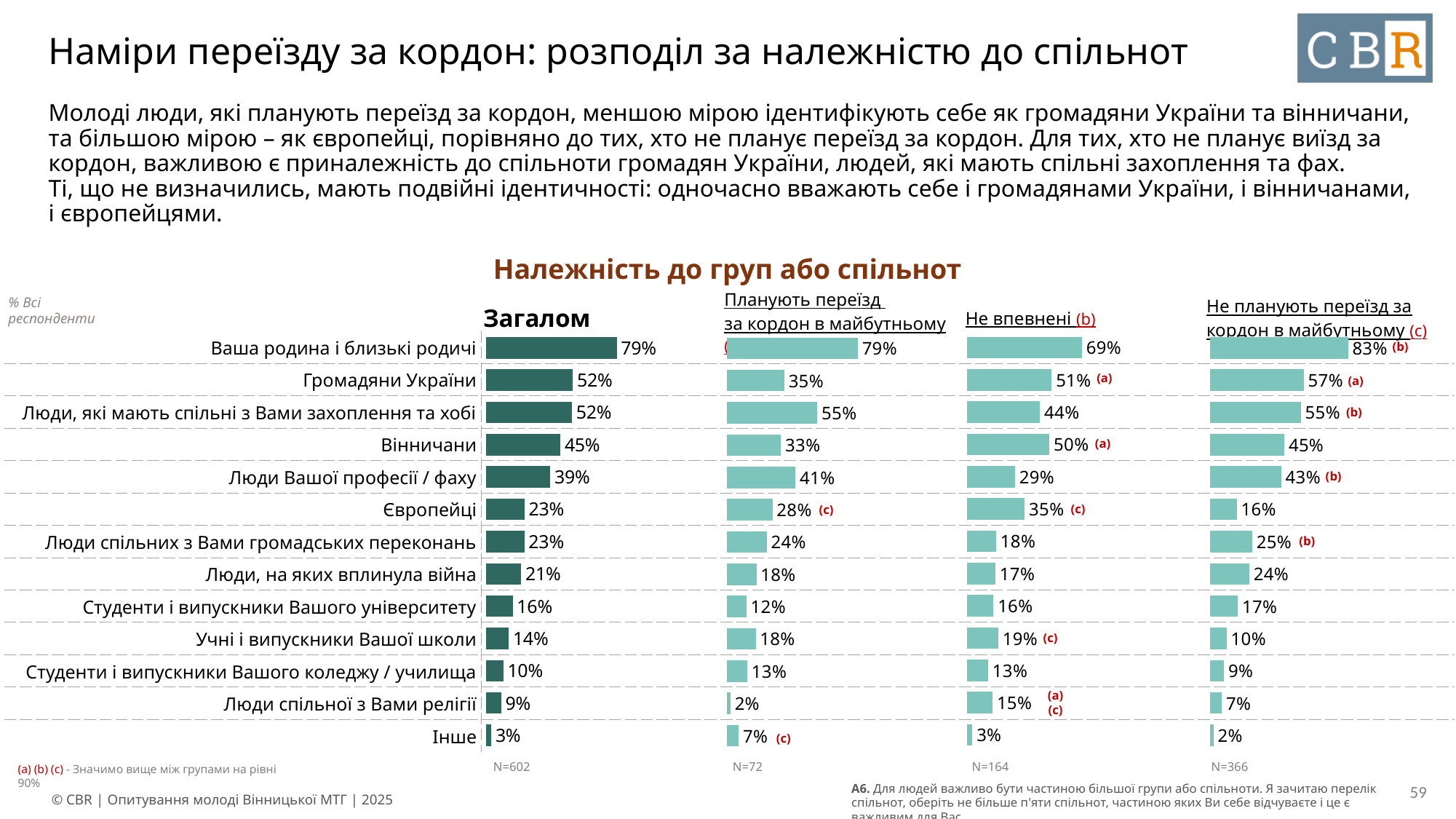
What type of chart is used for the "Загалом" data? Bar chart What is the difference between the "Громадяни України" values in the "Не планують переїзд за кордон в майбутньому" chart and the "Планують переїзд за кордон в майбутньому" chart? 22 percentage points Which is larger: the value for "Європейці" in the "Планують переїзд за кордон в майбутньому" chart or in the "Не планують переїзд за кордон в майбутньому" chart? Планують переїзд за кордон в майбутньому In the "Не планують переїзд за кордон в майбутньому" chart, what is the value for "Вінничани"? 45% In the "Планують переїзд за кордон в майбутньому" chart, which category has the lowest value? Люди спільної з Вами релігії In the "Планують переїзд за кордон в майбутньому" chart, what is the value for "Громадяни України"? 35% In the "Не впевнені" chart, what is the value for "Люди спільної з Вами релігії"? 15% In the "Не впевнені" chart, what is the value for "Європейці"? 35% In the "Загалом" chart, what is the value for "Ваша родина і близькі родичі"? 79% What is the sample size (N) shown under the "Не впевнені" chart? N=164 In the "Не планують переїзд за кордон в майбутньому" chart, which category has the highest value? Ваша родина і близькі родичі How many categories are listed in the "Загалом" chart? 13